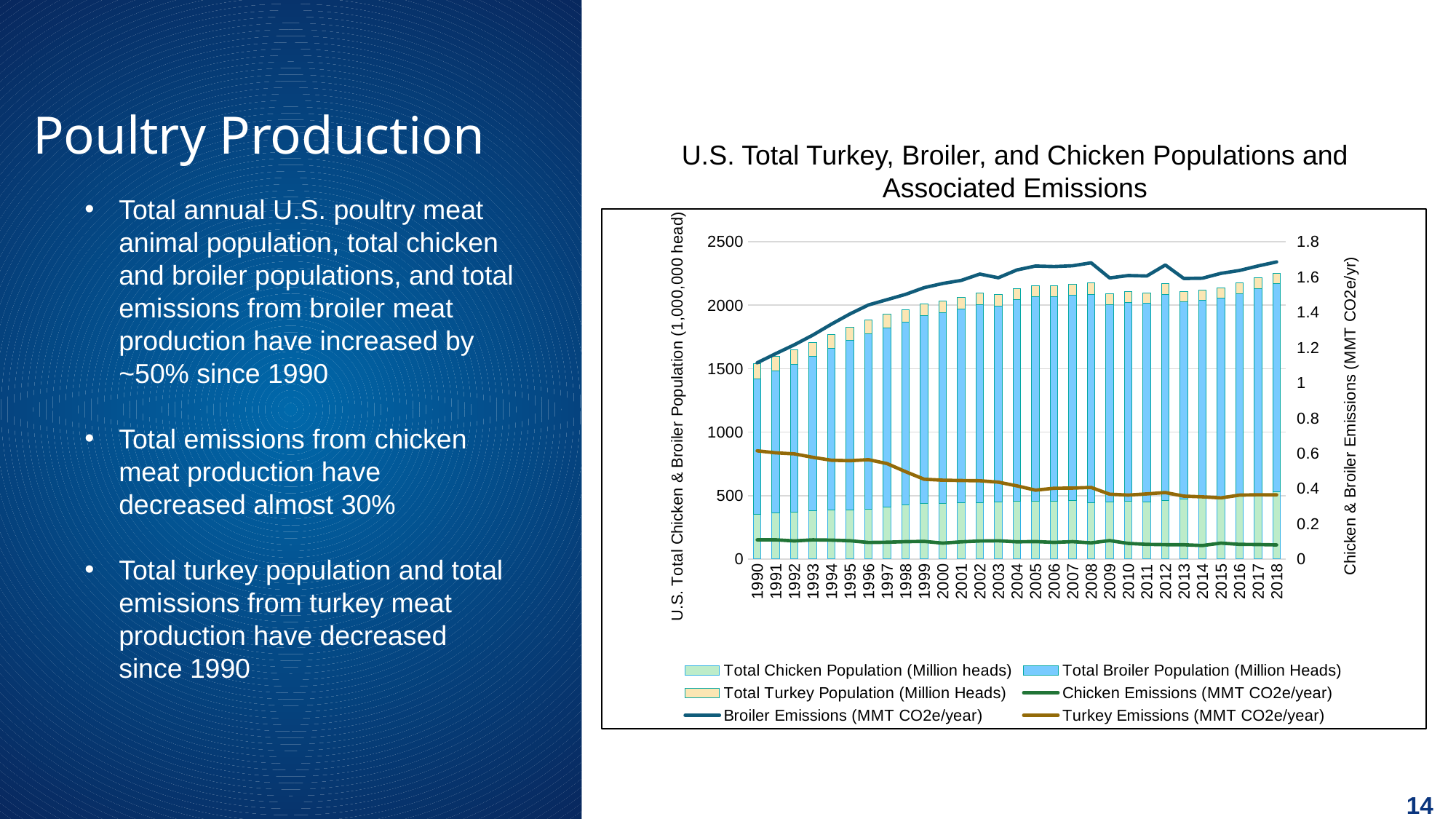
Is the Chicken Emissions value for 2018 greater or less than 0.2? less Do the Turkey Emissions values generally rise or fall from 1990 to 2018? Fall What kind of chart is shown on the slide? A combined stacked bar and line chart Do the Broiler Emissions values generally rise or fall from 1990 to 2018? Rise Is the total stacked population bar for 2018 greater or less than 2000? greater How many series does the legend list? 6 In 2018, which is larger: Broiler Emissions or Turkey Emissions? Broiler Emissions Is the Broiler Emissions value for 2018 greater or less than 1.4? greater What is the first year shown on the x axis? 1990 Which is larger: Turkey Emissions in 1990 or Turkey Emissions in 2018? 1990 What is the title of the chart? U.S. Total Turkey, Broiler, and Chicken Populations and Associated Emissions How many years are shown along the x axis? 29